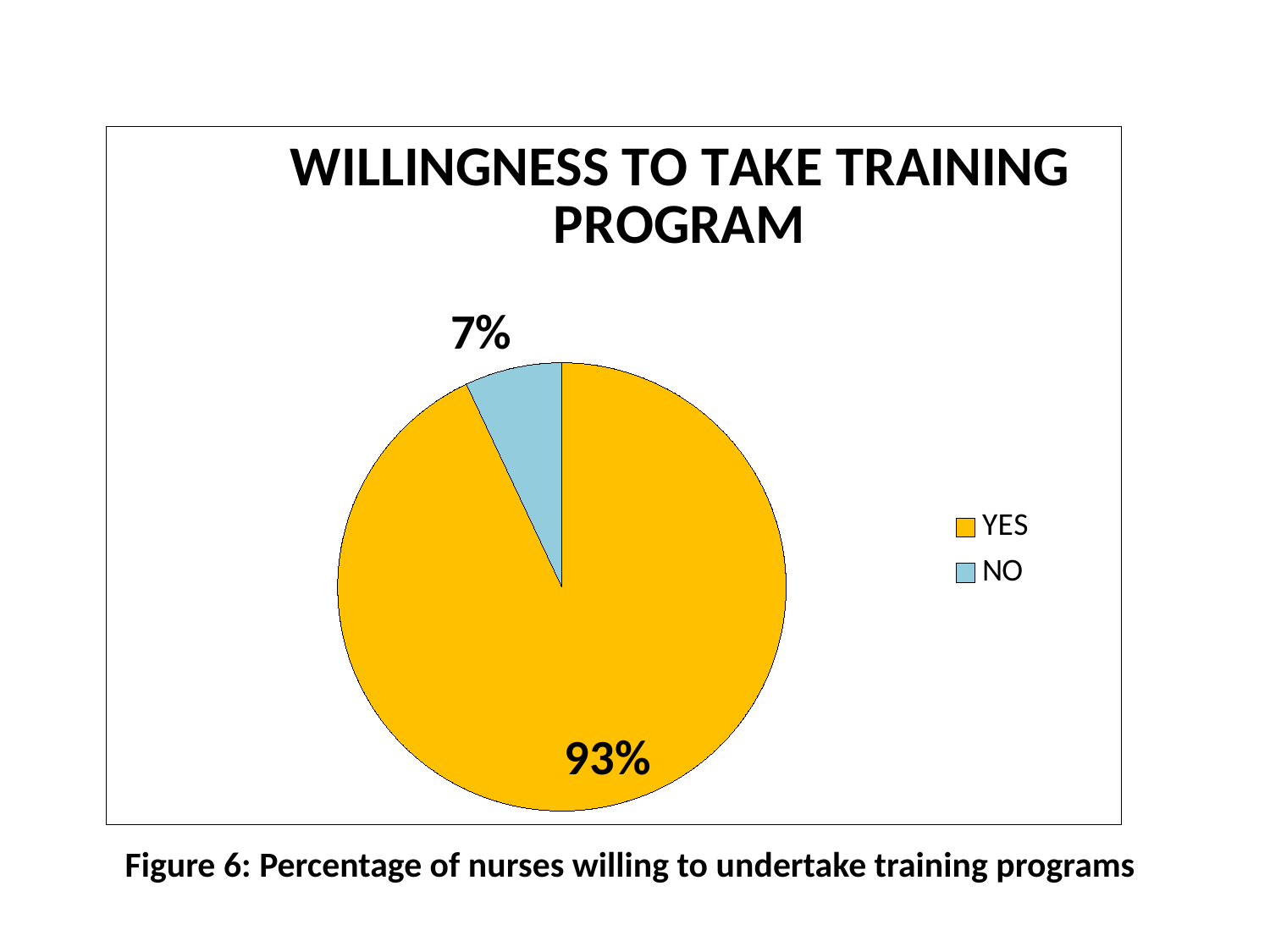
How many slices does the pie chart have? 2 What percentage of the pie is labelled YES? 93% What kind of chart is shown on the slide? Pie chart How many entries does the legend list? 2 What share of the pie does the YES slice represent? 93% What is the difference in percentage points between the YES and NO slices? 86 Which category has the largest share of the pie? YES What colour is the NO slice in the pie chart? Light blue Which slice is larger, YES or NO? YES Which category has the smallest share of the pie? NO What is the title of the chart? WILLINGNESS TO TAKE TRAINING PROGRAM What percentage of the pie is labelled NO? 7%